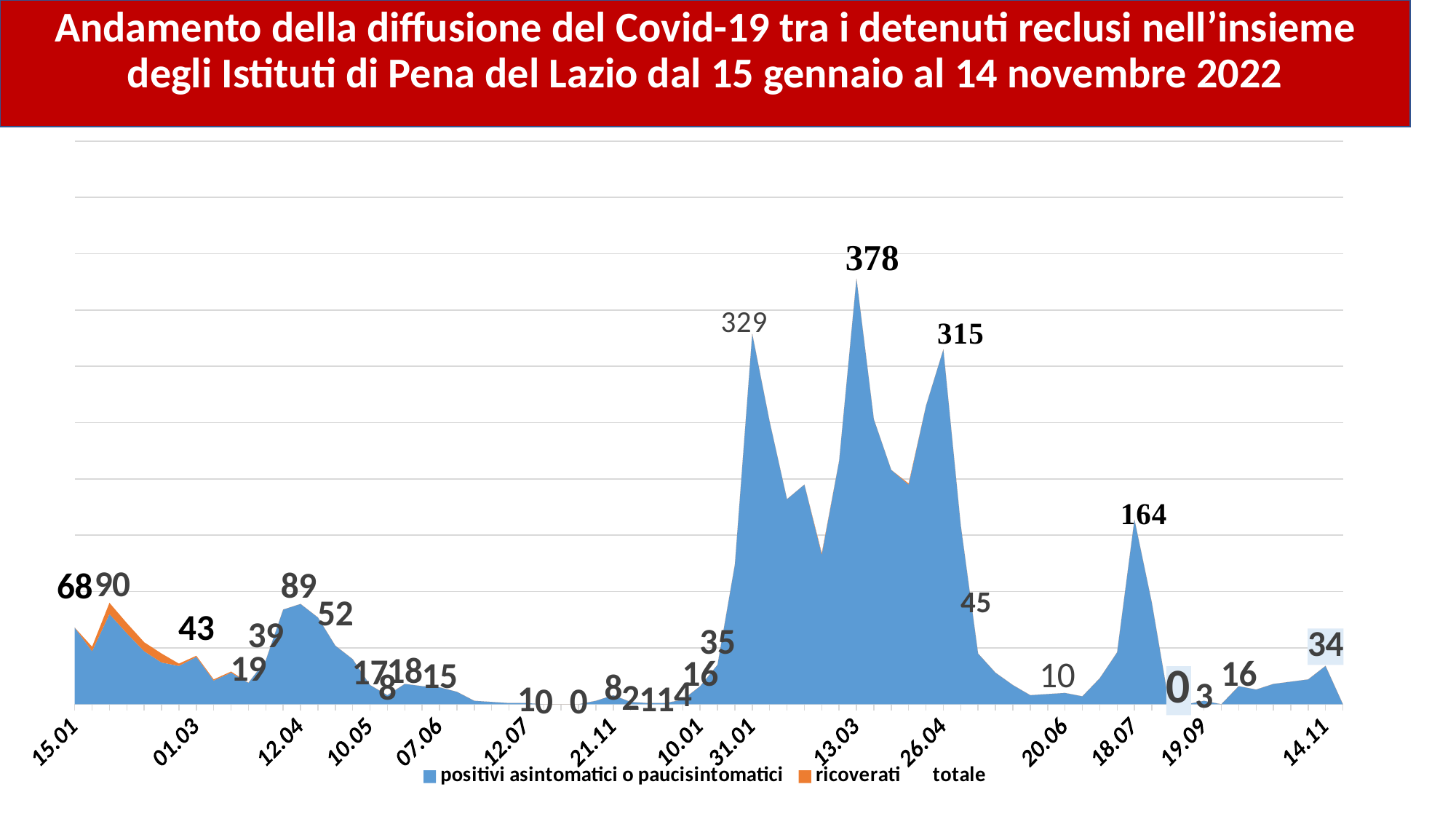
What is the difference between the peak labelled 378 and the peak labelled 329? 49 What is the value labelled at the peak near 18.07? 164 What is the first series listed in the legend? positivi asintomatici o paucisintomatici What type of chart is shown on the slide? area chart How many series does the legend list? 3 Which series is shown in orange in the legend? ricoverati What is the highest data label shown on the chart? 378 Which is larger, the peak labelled 329 or the peak labelled 315? 329 Do the values rise or fall between the peak near 13.03 and the point near 20.06? fall What is the value labelled at the last point, near 14.11? 34 What is the difference between the peak labelled 378 and the peak labelled 164? 214 What is the value labelled at the first point, 15.01? 68